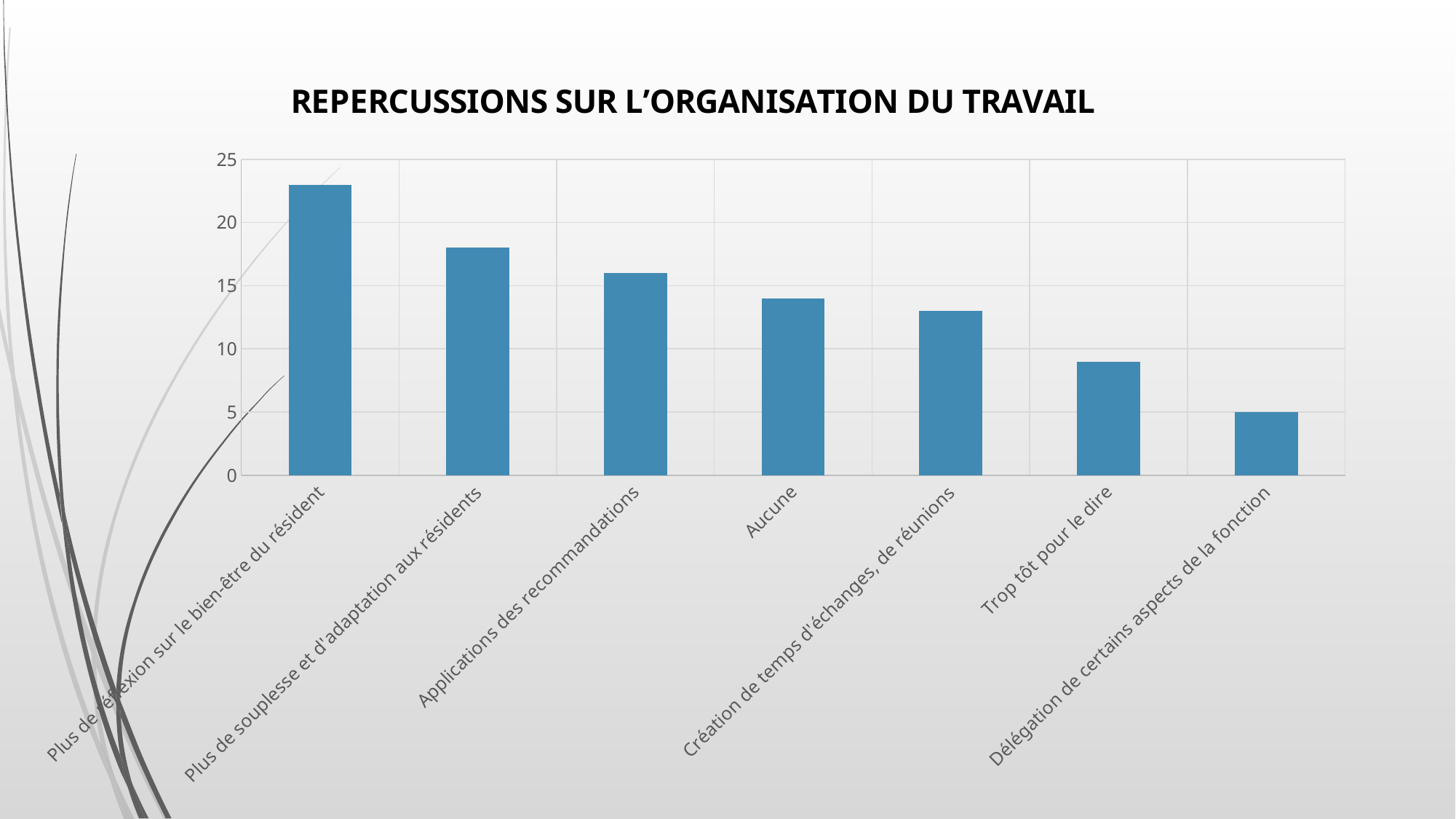
What is the value for Délégation de certains aspects de la fonction? 5 Which category has the highest value? Plus de réflexion sur le bien-être du résident Which is larger, the value for Plus de souplesse et d'adaptation aux résidents or the value for Aucune? Plus de souplesse et d'adaptation aux résidents Is the value for Plus de souplesse et d'adaptation aux résidents greater or less than 20? less How many categories are shown on the x axis of the chart? 7 Is the value for Création de temps d'échanges, de réunions greater or less than 10? greater What is the title of the chart? REPERCUSSIONS SUR L'ORGANISATION DU TRAVAIL Do the values rise or fall from left to right along the x axis? fall Which category has the lowest value? Délégation de certains aspects de la fonction What kind of chart is shown on the slide? bar chart Is the value for Applications des recommandations greater or less than 15? greater